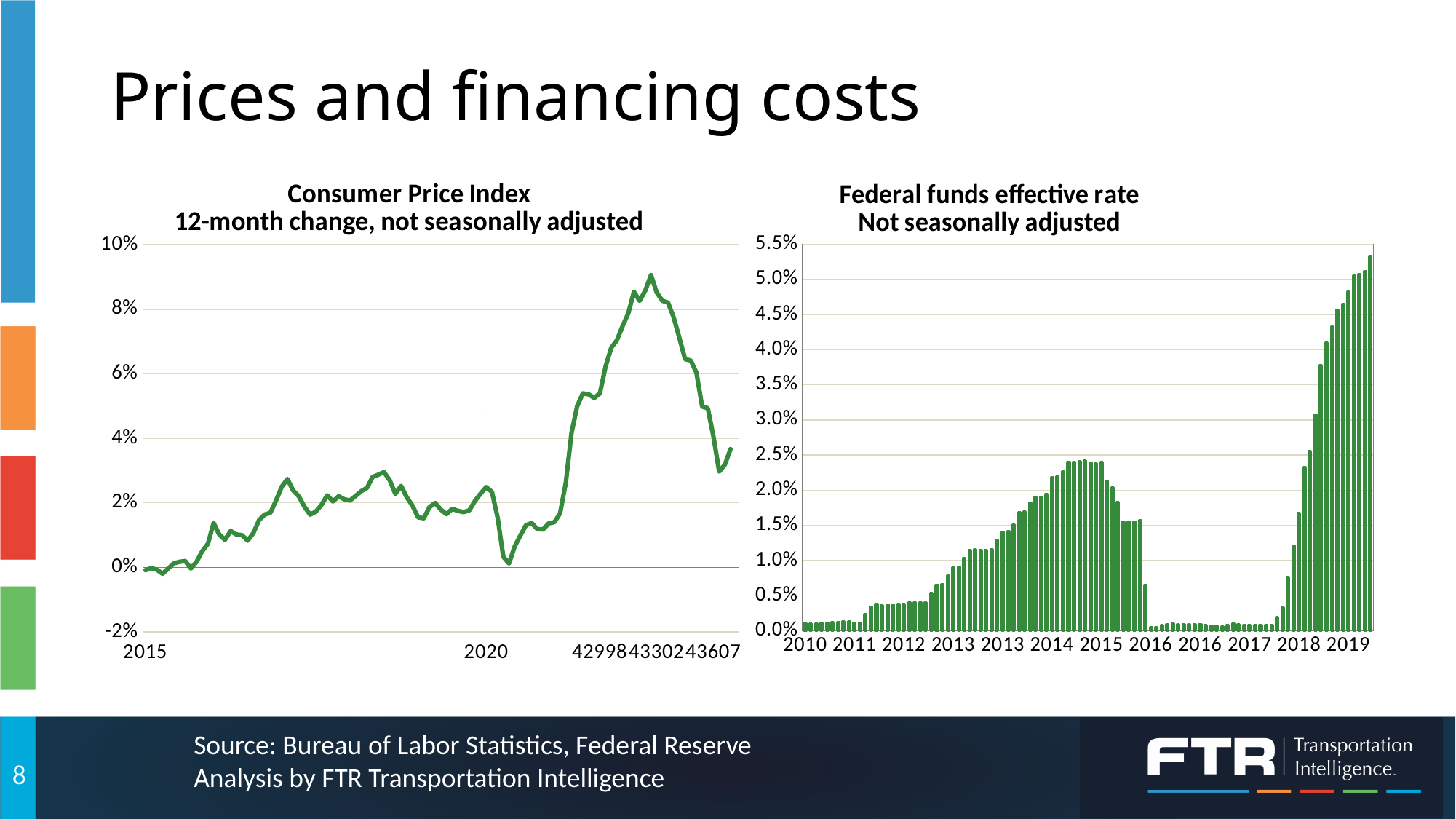
In the Consumer Price Index chart, is the peak value of the line greater or less than 8%? greater What is the highest value shown on the y-axis of the Federal funds effective rate chart? 5.5% In the Consumer Price Index chart, does the line rise or fall between the 2020 tick and its peak? rise In the Federal funds effective rate chart, are the bars around the 2017 label greater or less than 0.5%? less In the Federal funds effective rate chart, do the bars rise or fall from the 2015 label to the first 2016 label? fall In the Federal funds effective rate chart, is the tallest bar greater or less than 5.0%? greater What kind of chart is the Federal funds effective rate chart on the right? bar chart In the Federal funds effective rate chart, do the bars rise or fall from the 2018 label to the 2019 label? rise What is the subtitle line under 'Consumer Price Index' in the left chart's title? 12-month change, not seasonally adjusted What kind of chart is the Consumer Price Index chart on the left? line chart How many charts are shown on the slide? 2